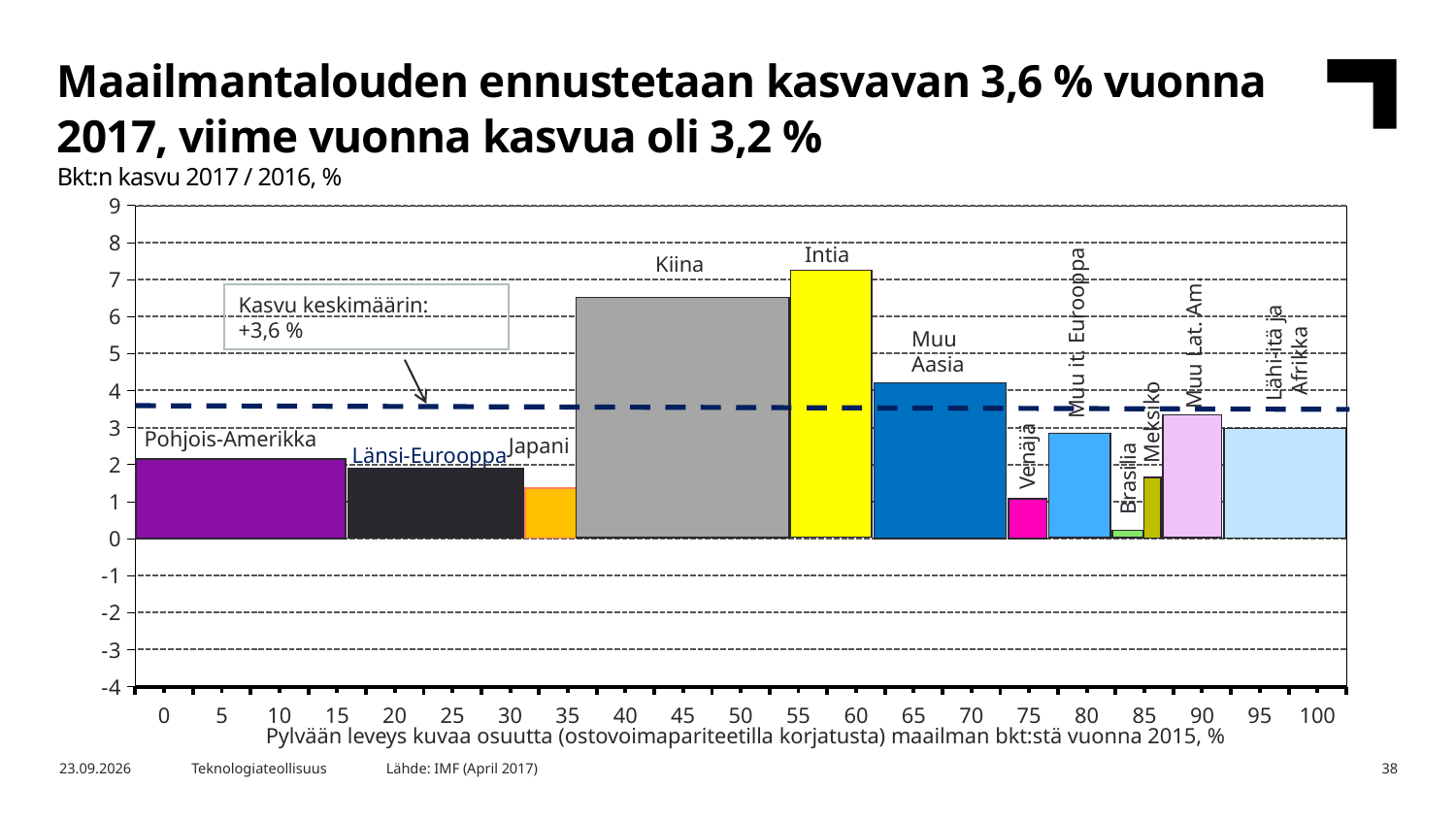
Which region has the lowest GDP growth in the chart? Brasilia Is the value for Venäjä greater or less than 2? less Which has the higher growth value, Kiina or Muu Aasia? Kiina Is the value for Muu Aasia greater or less than 3? greater Which has the higher growth value, Pohjois-Amerikka or Japani? Pohjois-Amerikka Is the value for Kiina greater or less than 6? greater How many regions are shown as bars in the chart? 12 Which region has the highest GDP growth in the chart? Intia According to the note below the chart, what does the width of each bar represent? The region's share of world GDP in 2015 (PPP-adjusted) What kind of chart is shown on the slide? bar chart What average growth value is marked by the dashed line in the chart? +3,6 %